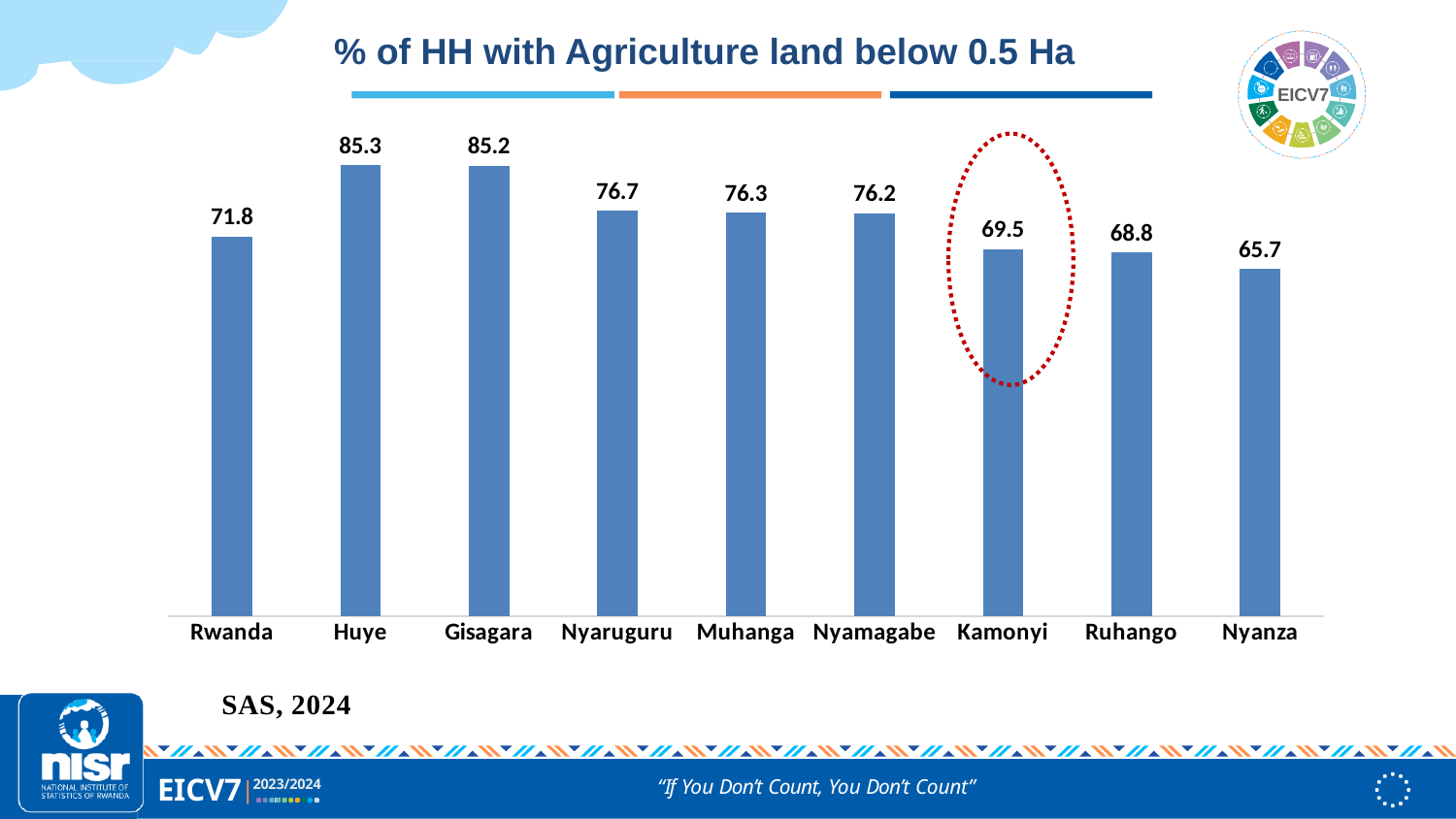
What is the value for Ruhango? 68.8 Which category has the highest value? Huye What is the value for Rwanda? 71.8 What is the difference between the values for Huye and Nyanza? 19.6 Which district has the lowest value? Nyanza What is the difference between the values for Rwanda and Kamonyi? 2.3 How many categories are shown on the x axis? 9 What kind of chart is shown on the slide? Bar chart Which is larger, the value for Nyaruguru or the value for Ruhango? Nyaruguru What is the value for Nyamagabe? 76.2 What is the value for Kamonyi? 69.5 Which district's bar is highlighted with a red dotted circle? Kamonyi